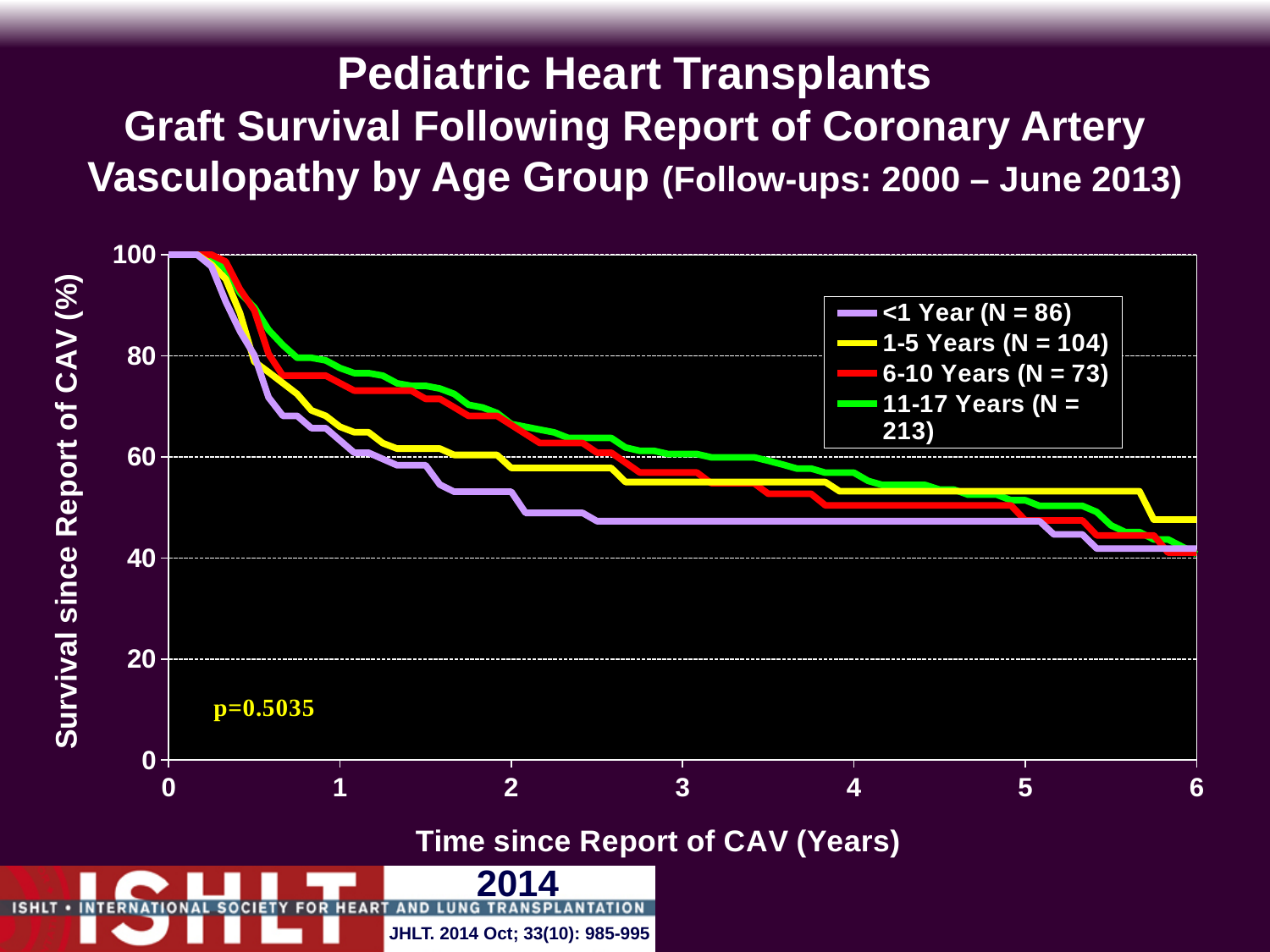
Is the survival value for the <1 Year group at 3 years greater or less than 60? less How many age-group series does the legend list? 4 Is the survival value for the 1-5 Years group at 6 years greater or less than 60? less What kind of chart is shown on the slide? Line chart What is the survival value for all groups at time 0? 100 Which age group has the lowest survival at 3 years since report of CAV? <1 Year At 3 years, which group has higher survival: <1 Year or 11-17 Years? 11-17 Years What p-value is printed on the chart? p=0.5035 Do the survival curves rise or fall as time since report of CAV increases? Fall What is the N for the 11-17 Years group shown in the legend? 213 Is the survival value for the 11-17 Years group at 1 year greater or less than 60? greater